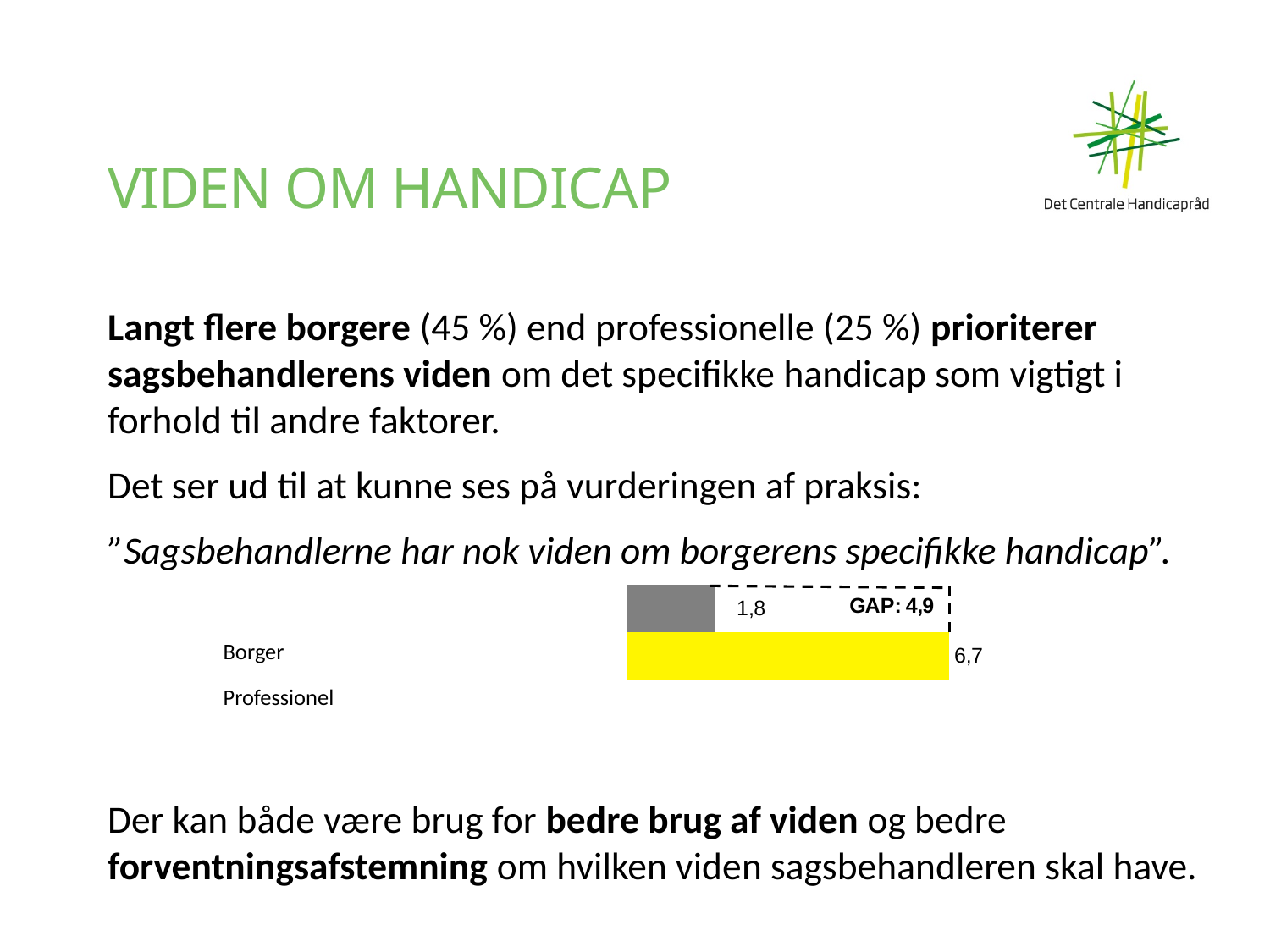
Which two group labels appear next to the chart? Borger and Professionel Which bar has the lowest value in the chart? the grey bar (1,8) What is the difference between the yellow bar (6,7) and the grey bar (1,8)? 4,9 How many bars are shown in the chart? 2 What value is printed on the grey bar in the chart? 1,8 Which bar has the highest value in the chart? the yellow bar (6,7) What statement is the chart evaluating, according to the italic text above it? Sagsbehandlerne har nok viden om borgerens specifikke handicap What kind of chart is shown on the slide? bar chart Which bar is longer, the grey bar or the yellow bar? the yellow bar What value is printed on the yellow bar in the chart? 6,7 What gap value is printed on the chart? GAP: 4,9